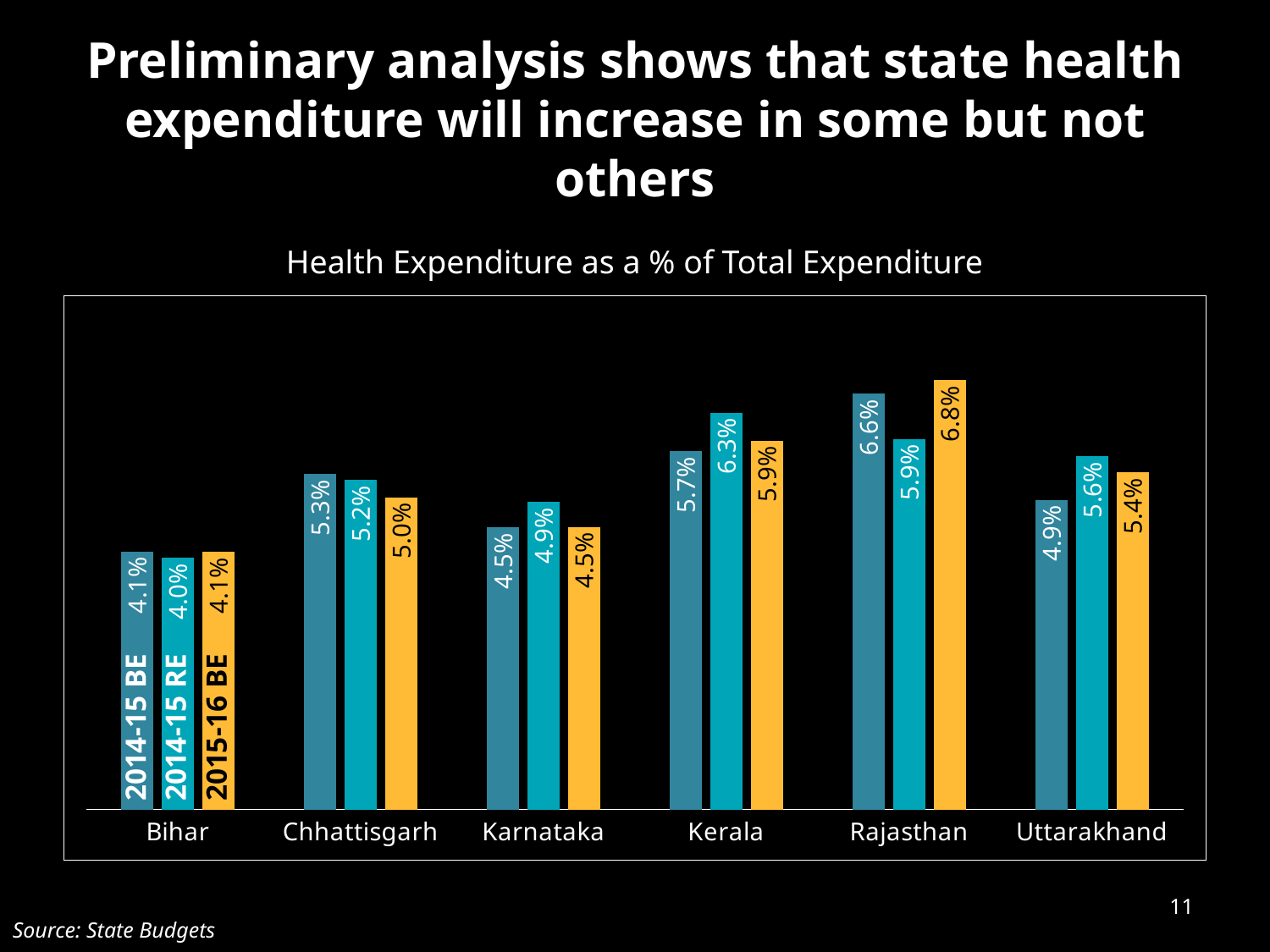
What is the 2014-15 BE value for Uttarakhand? 4.9% What is the difference between the 2015-16 BE and 2014-15 BE values for Uttarakhand? 0.5% Which state has the lowest 2014-15 RE value? Bihar What is the 2014-15 RE value for Kerala? 6.3% Which is larger for Chhattisgarh: the 2014-15 BE value or the 2015-16 BE value? 2014-15 BE How many states are shown on the x axis? 6 What is the source cited at the bottom of the slide? State Budgets Which state has the highest 2015-16 BE value? Rajasthan What is the title of the chart? Health Expenditure as a % of Total Expenditure How many series does the chart show? 3 What is the 2015-16 BE value for Rajasthan? 6.8% What kind of chart is shown on the slide? Bar chart